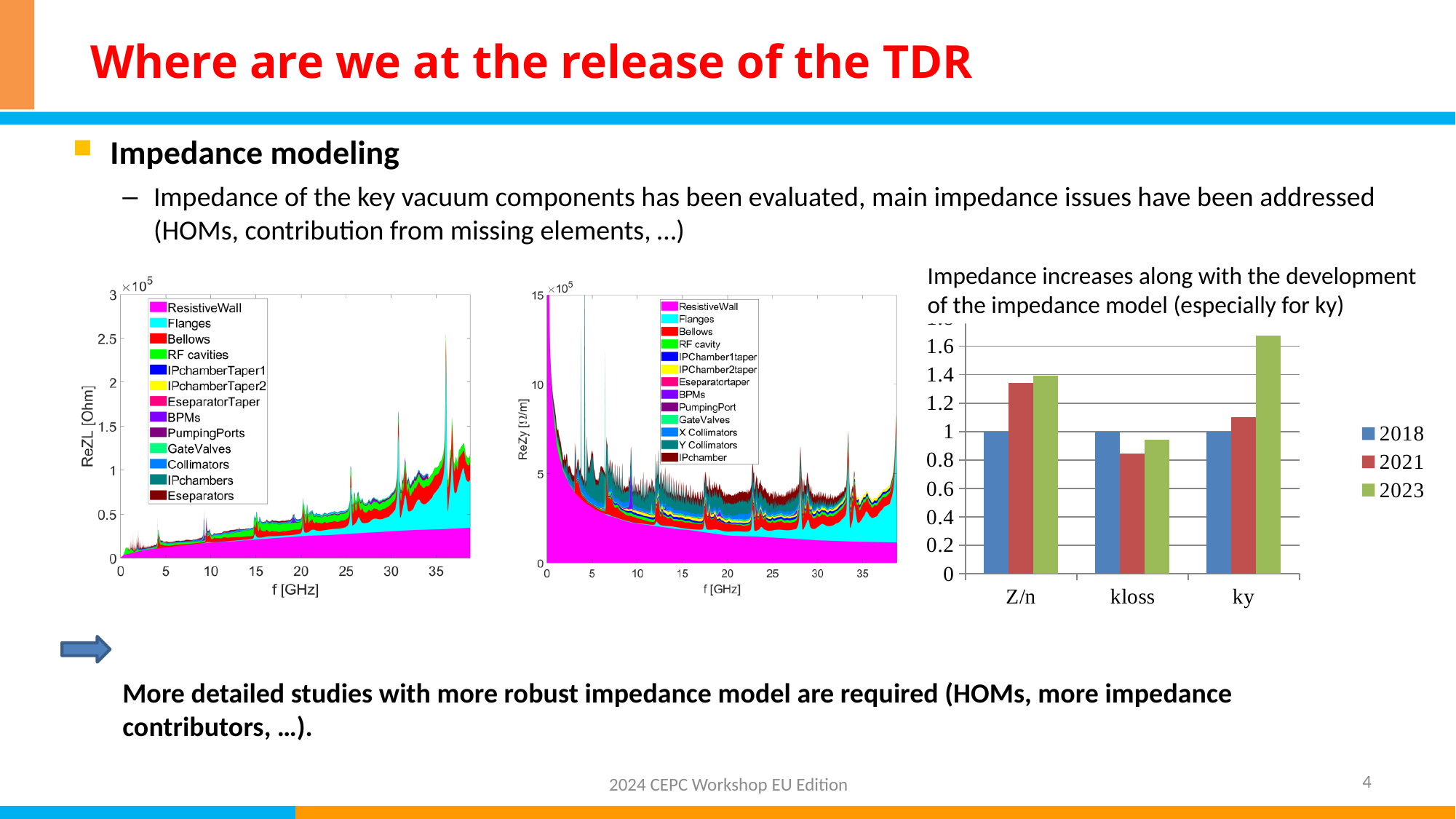
In the bar chart on the right, which is larger for ky: the 2021 value or the 2023 value? 2023 In the leftmost chart (ReZL vs f), does the total plotted impedance generally rise or fall as frequency increases? rise How many series does the legend of the bar chart on the right list? 3 In the bar chart on the right, what is the value for Z/n in 2018? 1 In the bar chart on the right, what is the value for ky in 2018? 1 In the bar chart on the right, which category has the lowest 2021 value? kloss In the bar chart on the right, is the 2021 value for kloss greater or less than 1? less What kind of chart is the chart on the right with categories Z/n, kloss and ky? bar chart In the bar chart on the right, is the 2021 value for Z/n greater or less than 1.2? greater In the bar chart on the right, is the 2023 value for ky greater or less than 1.6? greater In the bar chart on the right, which category has the highest bar overall? ky How many categories are shown on the x axis of the bar chart on the right? 3